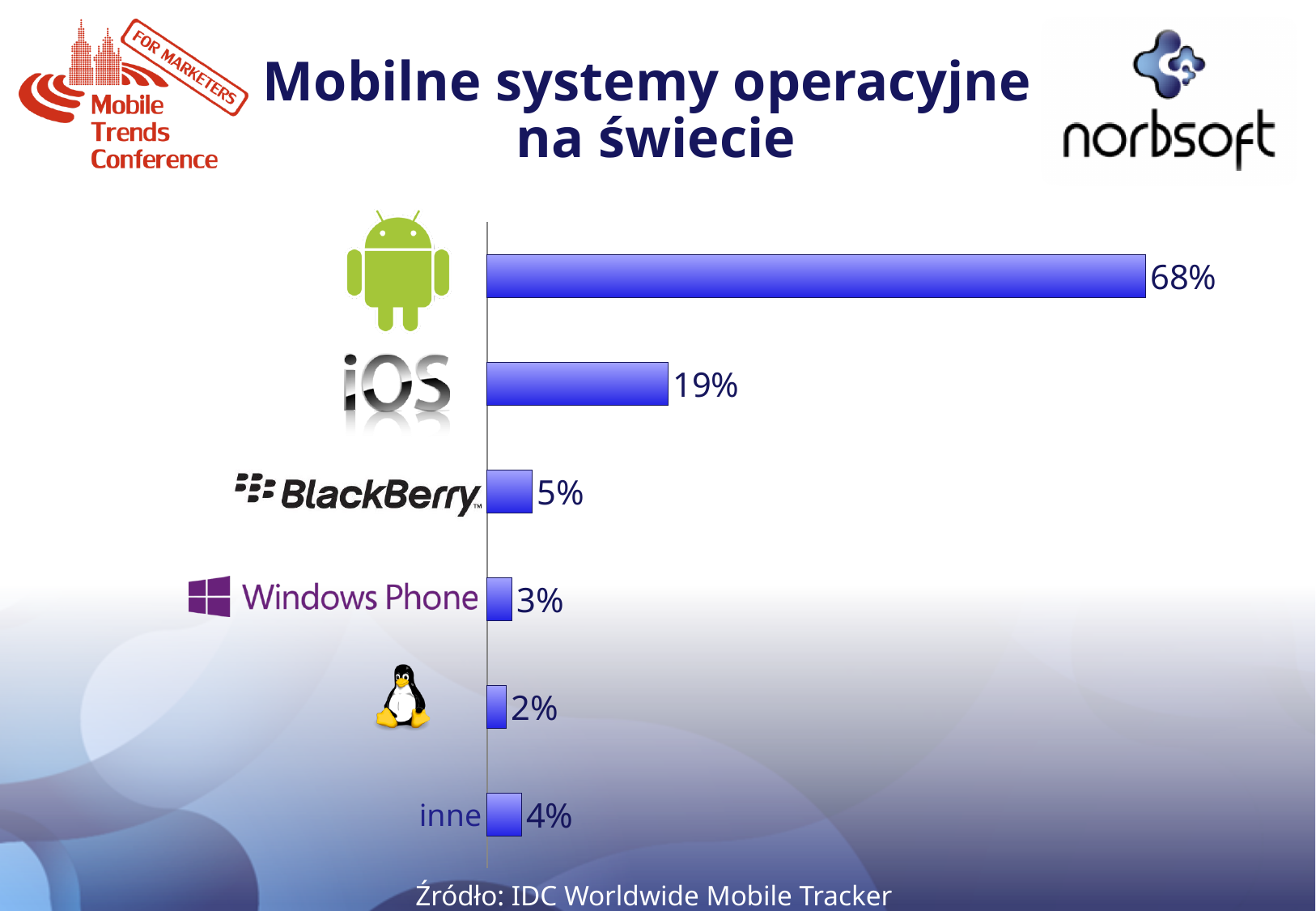
Which category has the lowest value? The one with the penguin (Linux) logo, 2% What kind of chart is shown on the slide? Bar chart What is the title of the slide? Mobilne systemy operacyjne na świecie What is the value for iOS? 19% What is the value for Android? 68% Which category has the highest value? Android What is the value for the category labelled "inne"? 4% What is the difference between the values for Android and iOS? 49% What is the value for BlackBerry? 5% How many categories are shown in the chart? 6 Which is larger, the value for BlackBerry or the value for Windows Phone? BlackBerry What is the value for Windows Phone? 3%